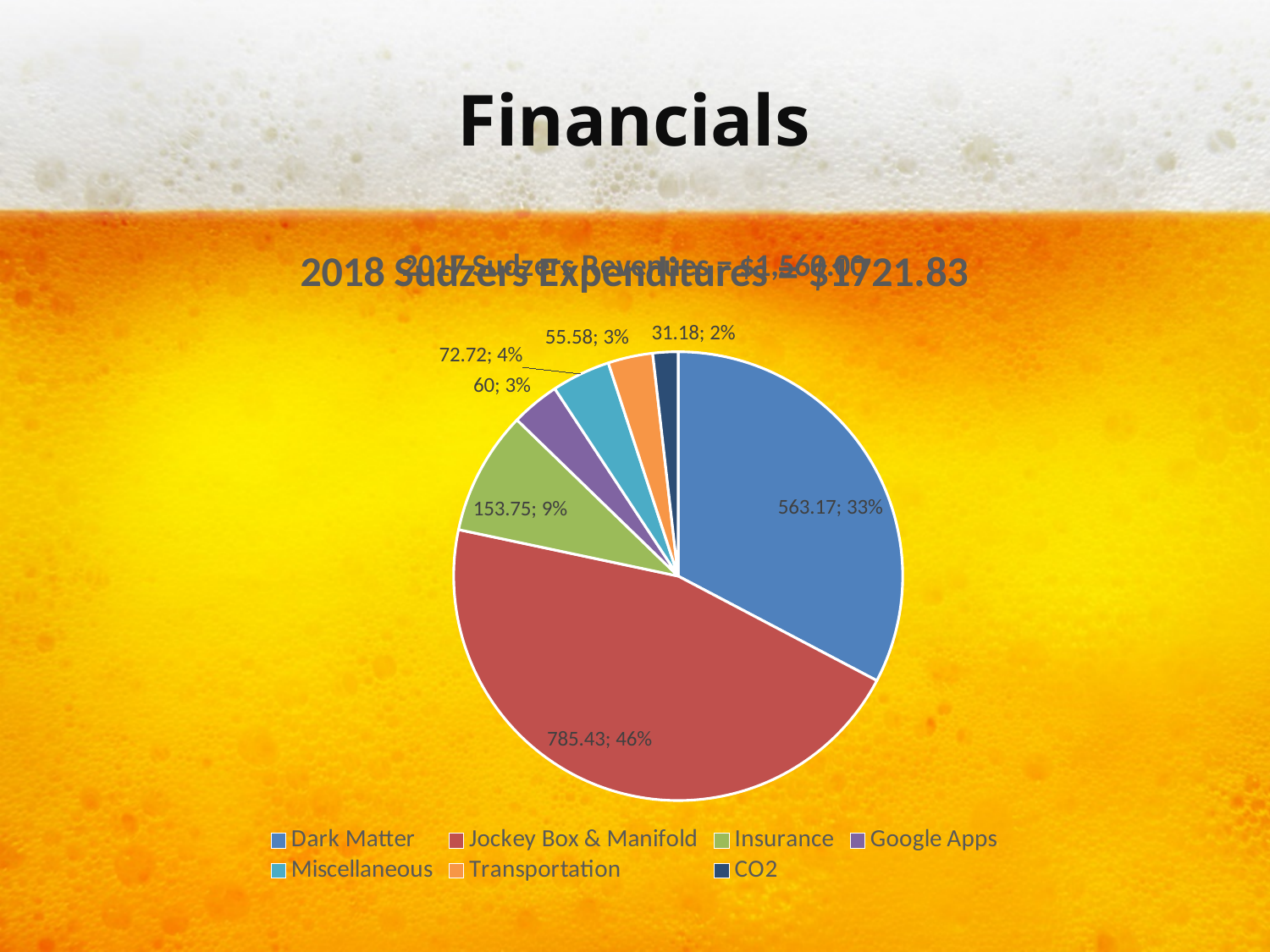
Which category has the smallest slice of the pie chart? CO2 Which category has the largest slice of the pie chart? Jockey Box & Manifold What is the value for CO2 in the pie chart? 31.18 How many categories does the pie chart show? 7 What is the value for Dark Matter in the pie chart? 563.17 What share of the pie does Insurance represent? 9% What is the value for Insurance in the pie chart? 153.75 What type of chart is shown on the slide? Pie chart Which is larger, the value for Miscellaneous or the value for Transportation? Miscellaneous What share of the pie does Dark Matter represent? 33% What is the difference between the values for Jockey Box & Manifold and Dark Matter? 222.26 What is the value for Jockey Box & Manifold in the pie chart? 785.43